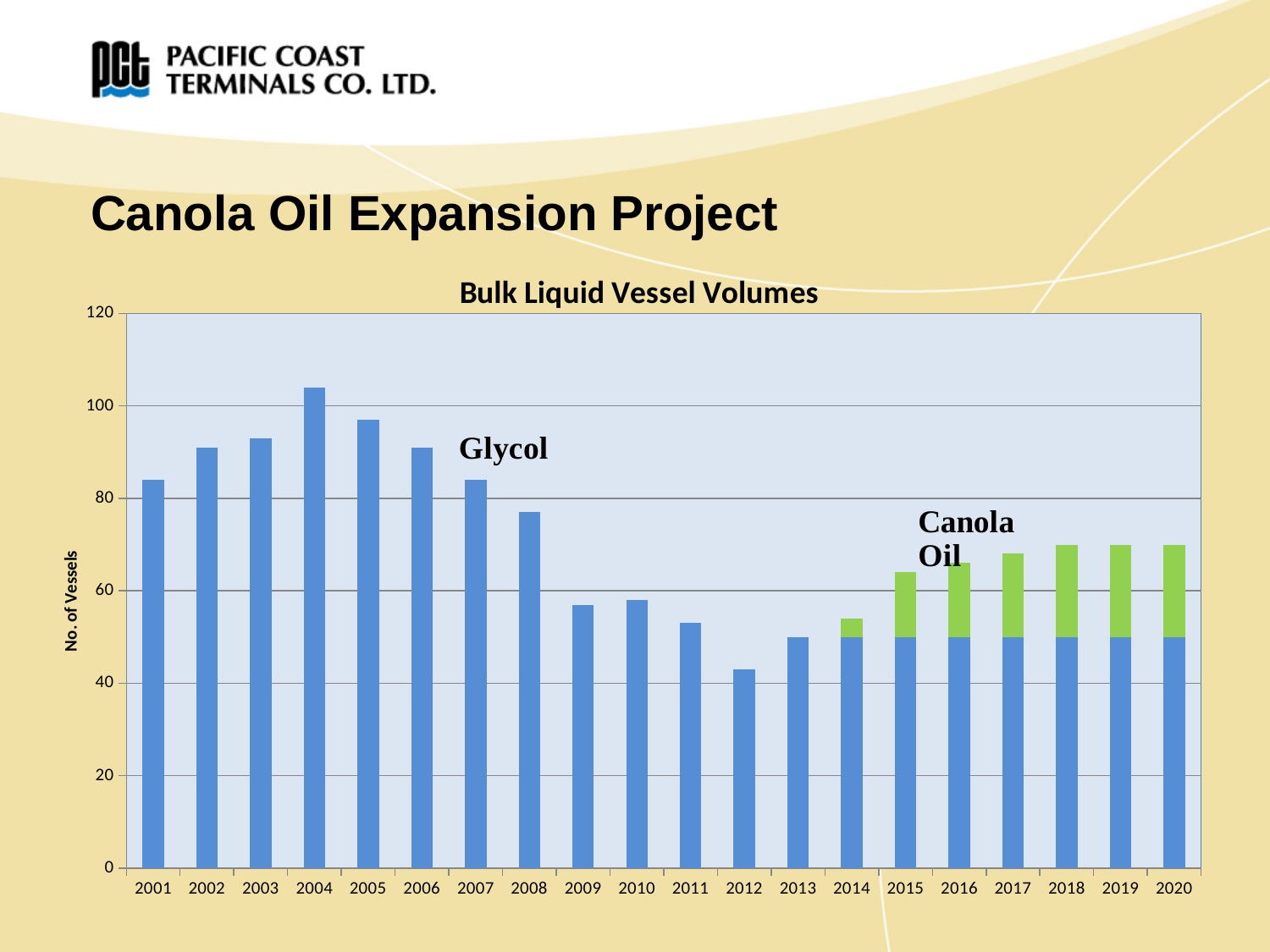
Which year has the highest number of vessels? 2004 Is the total value for 2020 greater or less than 60? greater How many years are shown along the x axis of the chart? 20 What is the label on the vertical axis of the chart? No. of Vessels Which year has more vessels, 2002 or 2010? 2002 What type of chart is shown on the slide? bar chart Which year has the lowest number of vessels? 2012 Do the values rise or fall from 2004 to 2012? fall Which year has more vessels, 2005 or 2006? 2005 Is the value for 2005 greater or less than 80? greater Is the value for 2012 greater or less than 60? less What is the title of the chart? Bulk Liquid Vessel Volumes